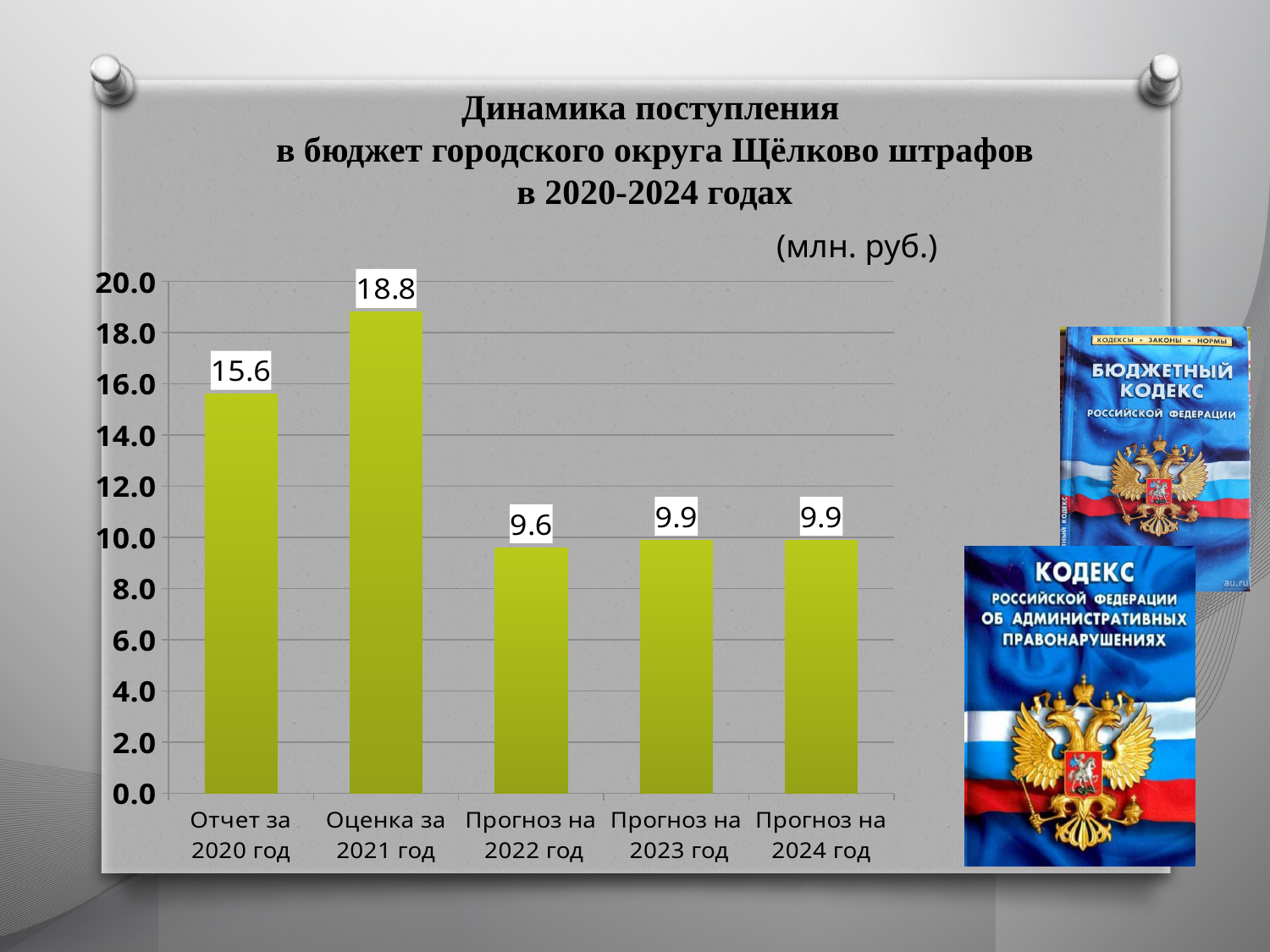
What is the value for "Отчет за 2020 год"? 15.6 Which category has the lowest value? Прогноз на 2022 год Which category has the highest value? Оценка за 2021 год What kind of chart is shown on the slide? bar chart What is the difference between the values for "Оценка за 2021 год" and "Отчет за 2020 год"? 3.2 What is the value for "Прогноз на 2022 год"? 9.6 Is the value for "Прогноз на 2022 год" greater or less than 10.0? less Which is larger: the value for "Отчет за 2020 год" or the value for "Прогноз на 2023 год"? Отчет за 2020 год What unit is indicated for the values in the chart? млн. руб. What is the value for "Оценка за 2021 год"? 18.8 What is the value for "Прогноз на 2024 год"? 9.9 How many categories are shown on the x axis? 5